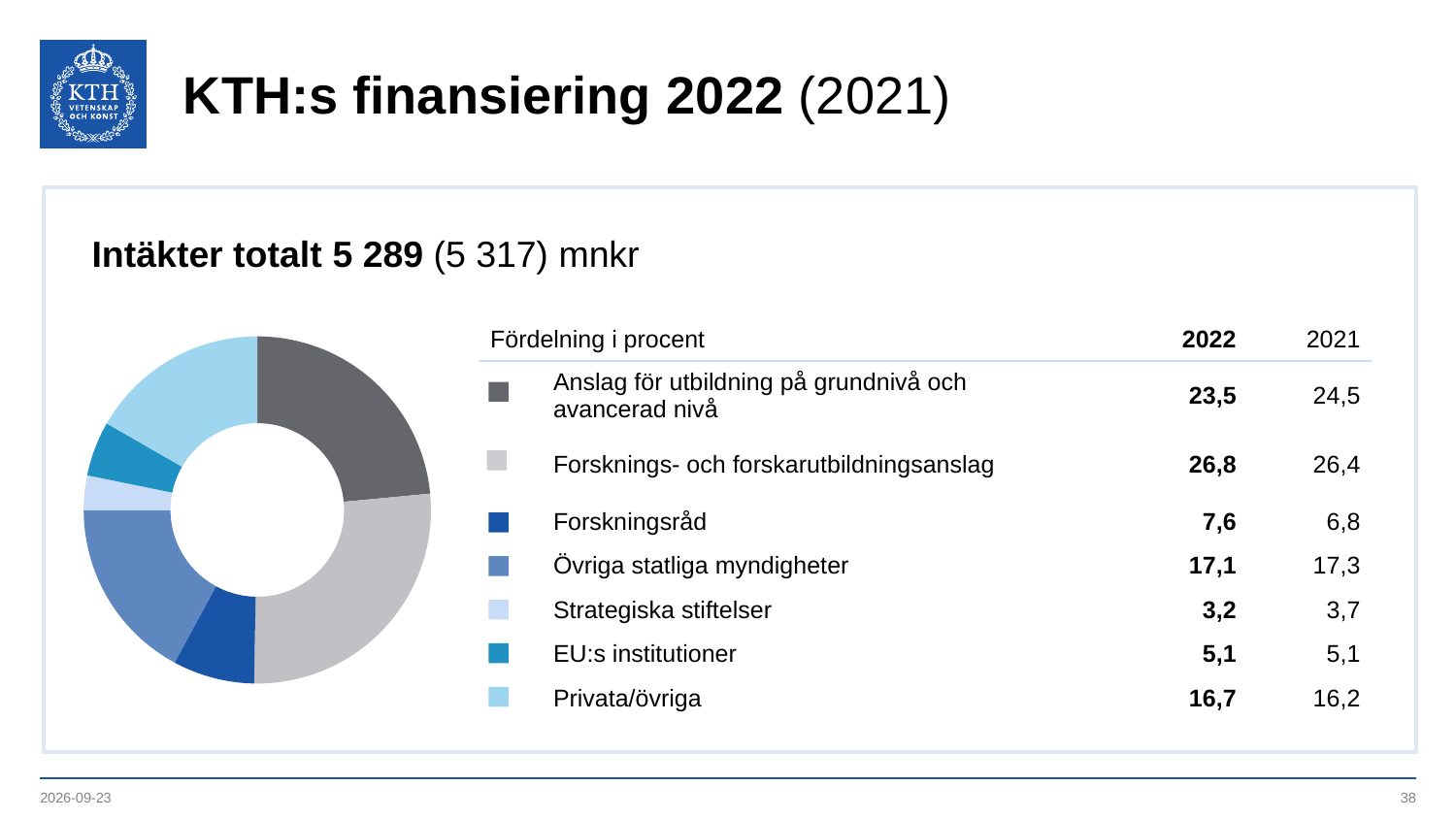
What kind of chart is shown on the slide? Doughnut (pie) chart What is the difference between the 2022 values for Forsknings- och forskarutbildningsanslag and Anslag för utbildning på grundnivå och avancerad nivå? 3,3 What is the 2022 value for EU:s institutioner? 5,1 What was the 2021 value for Anslag för utbildning på grundnivå och avancerad nivå? 24,5 Which category has the largest share in 2022? Forsknings- och forskarutbildningsanslag What is the 2022 value for Forskningsråd? 7,6 Which category has the smallest share in 2022? Strategiska stiftelser What is the total income (Intäkter totalt) for 2022 stated on the slide? 5 289 mnkr What is the 2022 value for Privata/övriga? 16,7 How many categories does the chart's legend list? 7 What share of the 2022 total does Strategiska stiftelser represent? 3,2 percent Which is larger in 2022: Övriga statliga myndigheter or Privata/övriga? Övriga statliga myndigheter